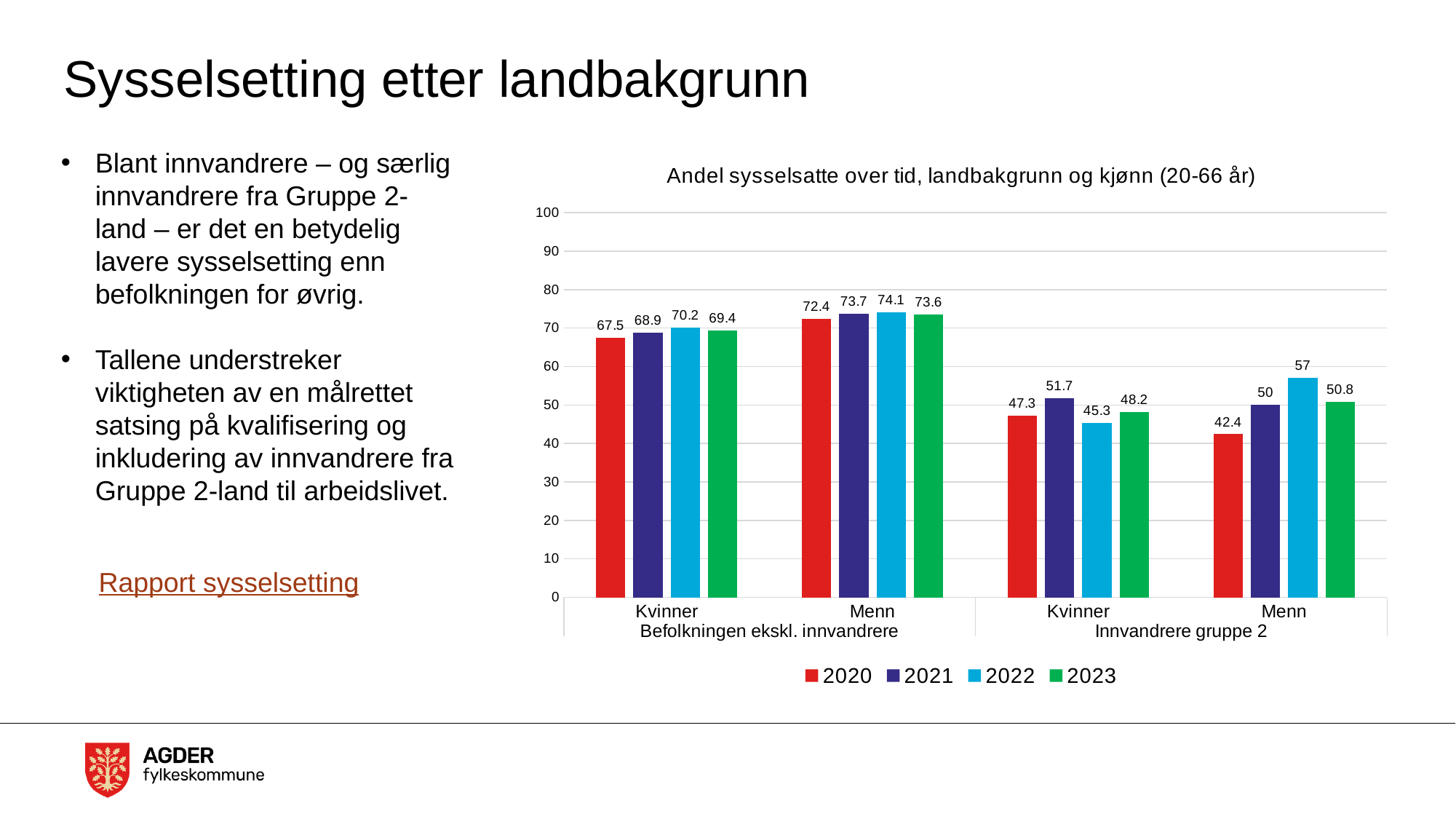
What is the difference between the 2023 values for Menn and Kvinner in Befolkningen ekskl. innvandrere? 4.2 Which year has the highest value for Menn in Befolkningen ekskl. innvandrere? 2022 Do the values for Menn in Befolkningen ekskl. innvandrere rise or fall from 2020 to 2022? Rise How many series does the legend list? 4 What is the title of the chart? Andel sysselsatte over tid, landbakgrunn og kjønn (20-66 år) What is the value for Kvinner in Innvandrere gruppe 2 for 2021? 51.7 What is the value for Kvinner in Befolkningen ekskl. innvandrere for 2020? 67.5 Is the 2020 value for Menn in Innvandrere gruppe 2 greater or less than 50? less Which is larger: the 2022 value for Kvinner in Innvandrere gruppe 2 or the 2023 value for Kvinner in Innvandrere gruppe 2? 2023 What kind of chart is shown on the slide? Bar chart Which year has the lowest value for Menn in Innvandrere gruppe 2? 2020 What is the value for Menn in Innvandrere gruppe 2 for 2022? 57